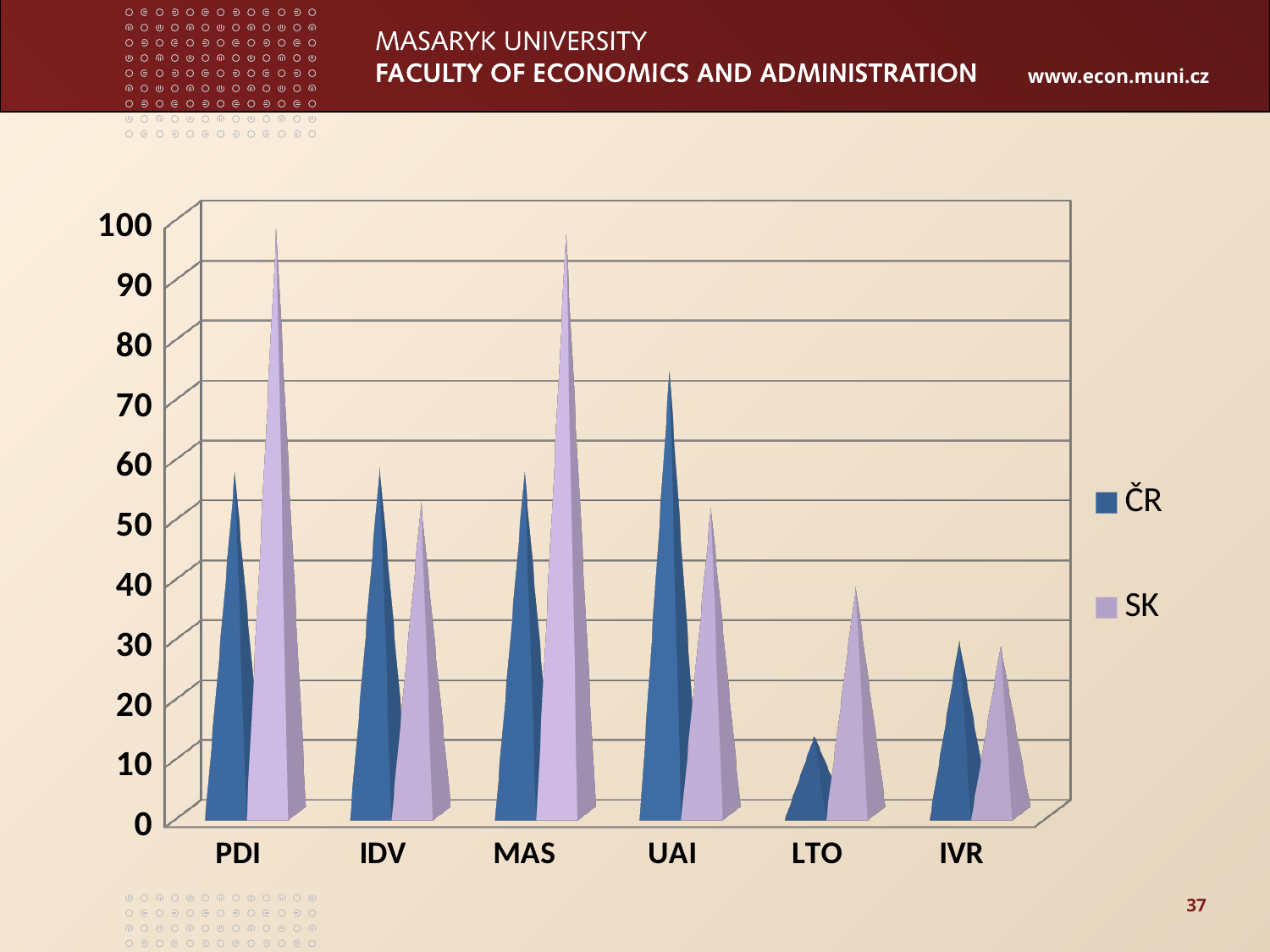
For UAI, which series has the larger value, ČR or SK? ČR Which two series are listed in the chart's legend? ČR and SK How many series does the chart's legend list? 2 For which category is the ČR value lowest? LTO For which category is the ČR value highest? UAI Is the SK value for PDI greater or less than 90? greater How many categories are shown on the x axis of the chart? 6 For which category is the SK value lowest? IVR For LTO, which series has the larger value, ČR or SK? SK What kind of chart is shown on the slide? bar chart For PDI, which series has the larger value, ČR or SK? SK Is the ČR value for LTO greater or less than 20? less